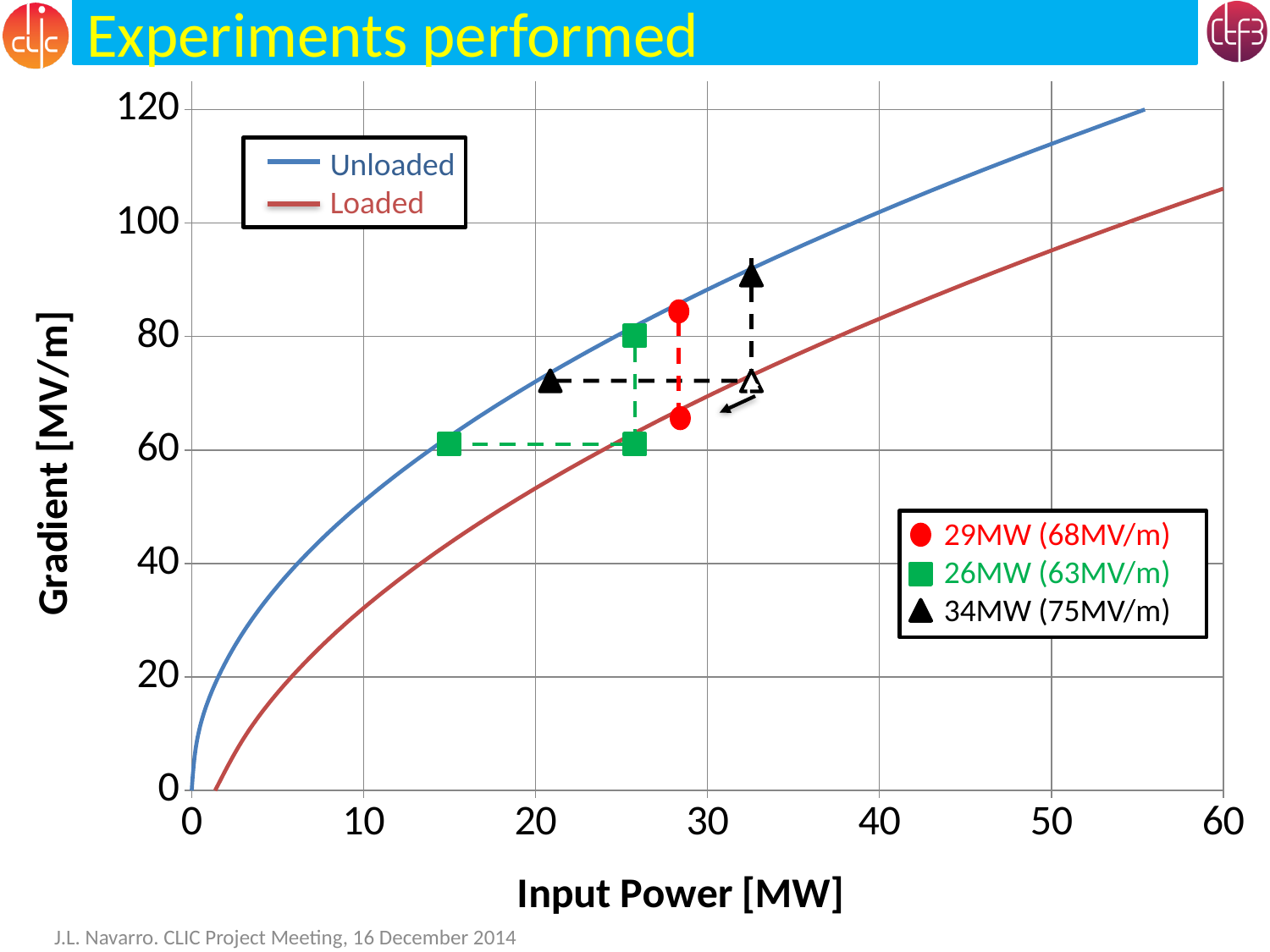
Does the Unloaded gradient rise or fall as input power increases along the x axis? rise What are the two series named in the upper-left legend? Unloaded and Loaded How many series does the upper-left legend list? 2 Is the Loaded gradient at 20 MW input power greater or less than 60 MV/m? less What is the label of the y axis? Gradient [MV/m] According to the lower-right legend, what gradient corresponds to the 26MW experiment point? 63MV/m Is the Unloaded gradient at 50 MW input power greater or less than 100 MV/m? greater According to the lower-right legend, what gradient corresponds to the 34MW experiment point? 75MV/m How many experiment points are listed in the lower-right legend? 3 What kind of chart is shown on the slide? line chart Is the Loaded gradient at 50 MW input power greater or less than 100 MV/m? less At an input power of 30 MW, which curve has the higher gradient, Unloaded or Loaded? Unloaded